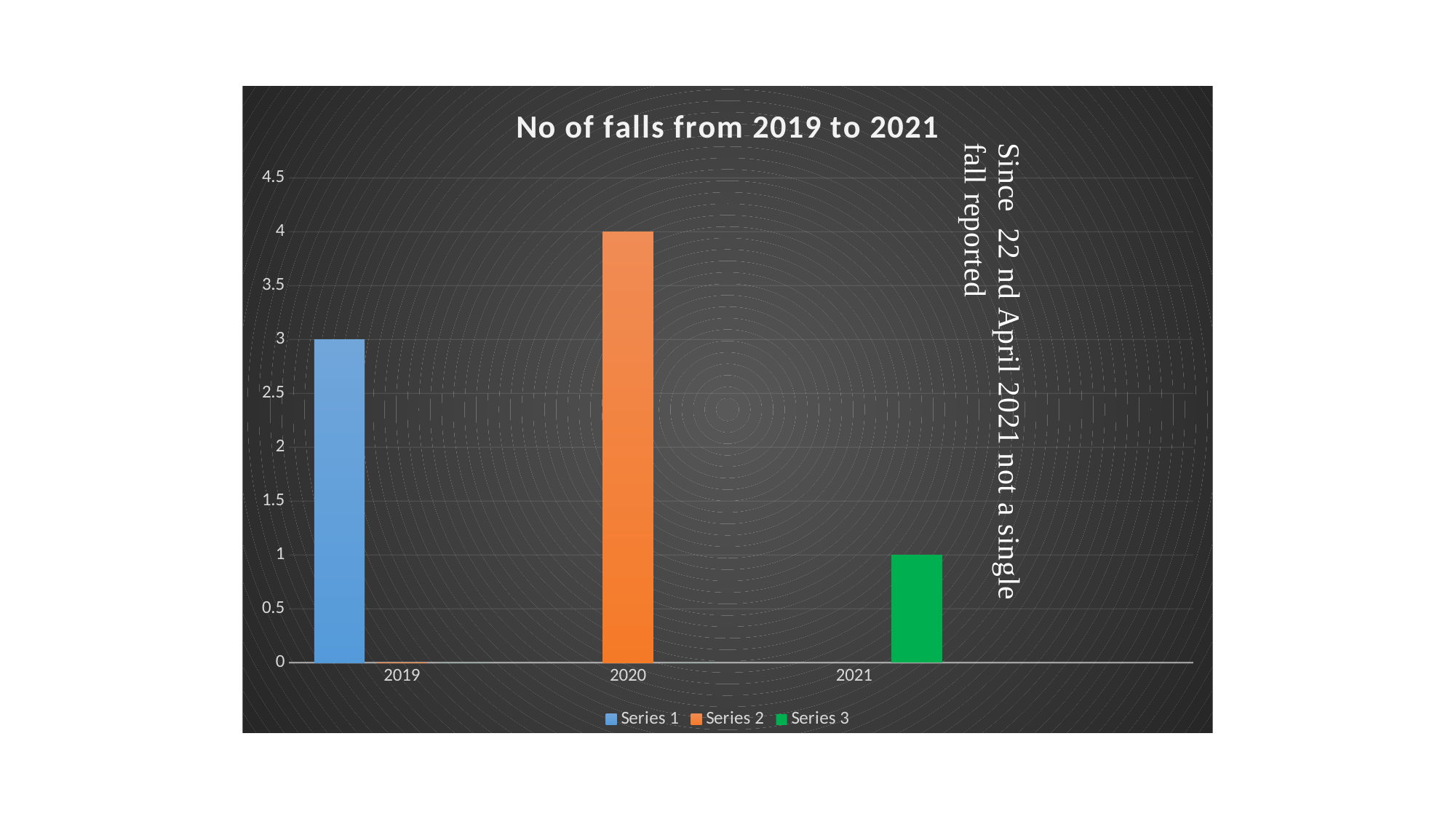
How many series does the legend list? 3 Is the value for 2020 greater or less than 3.5? greater What is the number of falls shown for 2019? 3 What is the title of the chart? No of falls from 2019 to 2021 What is the number of falls shown for 2021? 1 How many years are shown on the x axis? 3 What is the number of falls shown for 2020? 4 Which year has the lowest number of falls? 2021 What kind of chart is shown on the slide? Bar chart Which year has the highest number of falls? 2020 What is the difference between the number of falls in 2020 and in 2021? 3 Which year has more falls, 2019 or 2021? 2019